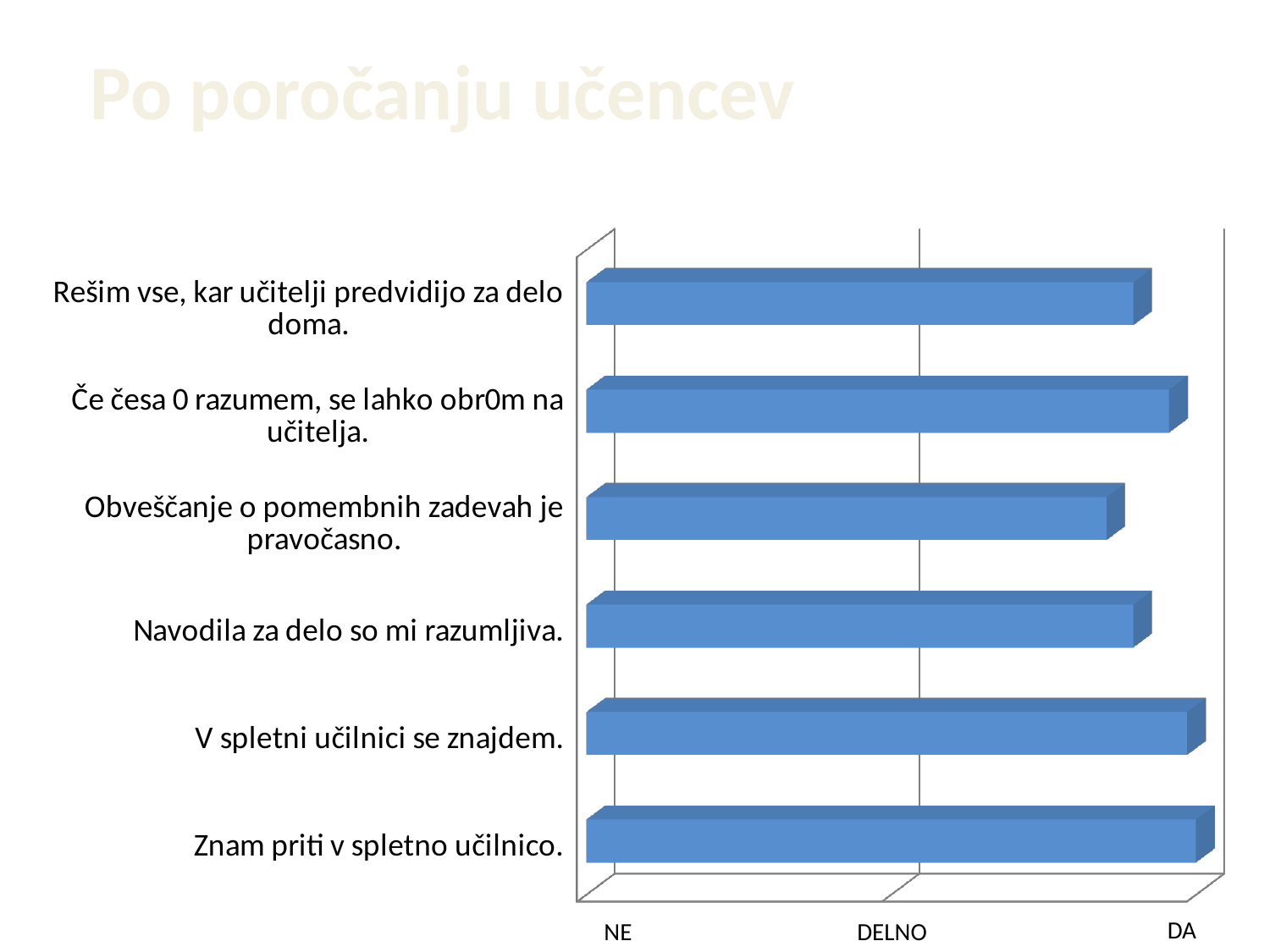
Which statement has the shortest bar in the chart? Obveščanje o pomembnih zadevah je pravočasno. What are the three labels shown on the horizontal axis of the chart? NE, DELNO, DA Which bar is longer: "Znam priti v spletno učilnico." or "Obveščanje o pomembnih zadevah je pravočasno."? Znam priti v spletno učilnico. What is the title of the slide containing the chart? Po poročanju učencev What kind of chart is shown on the slide? bar chart Does the bar for "Obveščanje o pomembnih zadevah je pravočasno." extend beyond the DELNO tick on the axis? yes How many categories (statements) are plotted in the chart? 6 Which bar is longer: "V spletni učilnici se znajdem." or "Rešim vse, kar učitelji predvidijo za delo doma."? V spletni učilnici se znajdem.